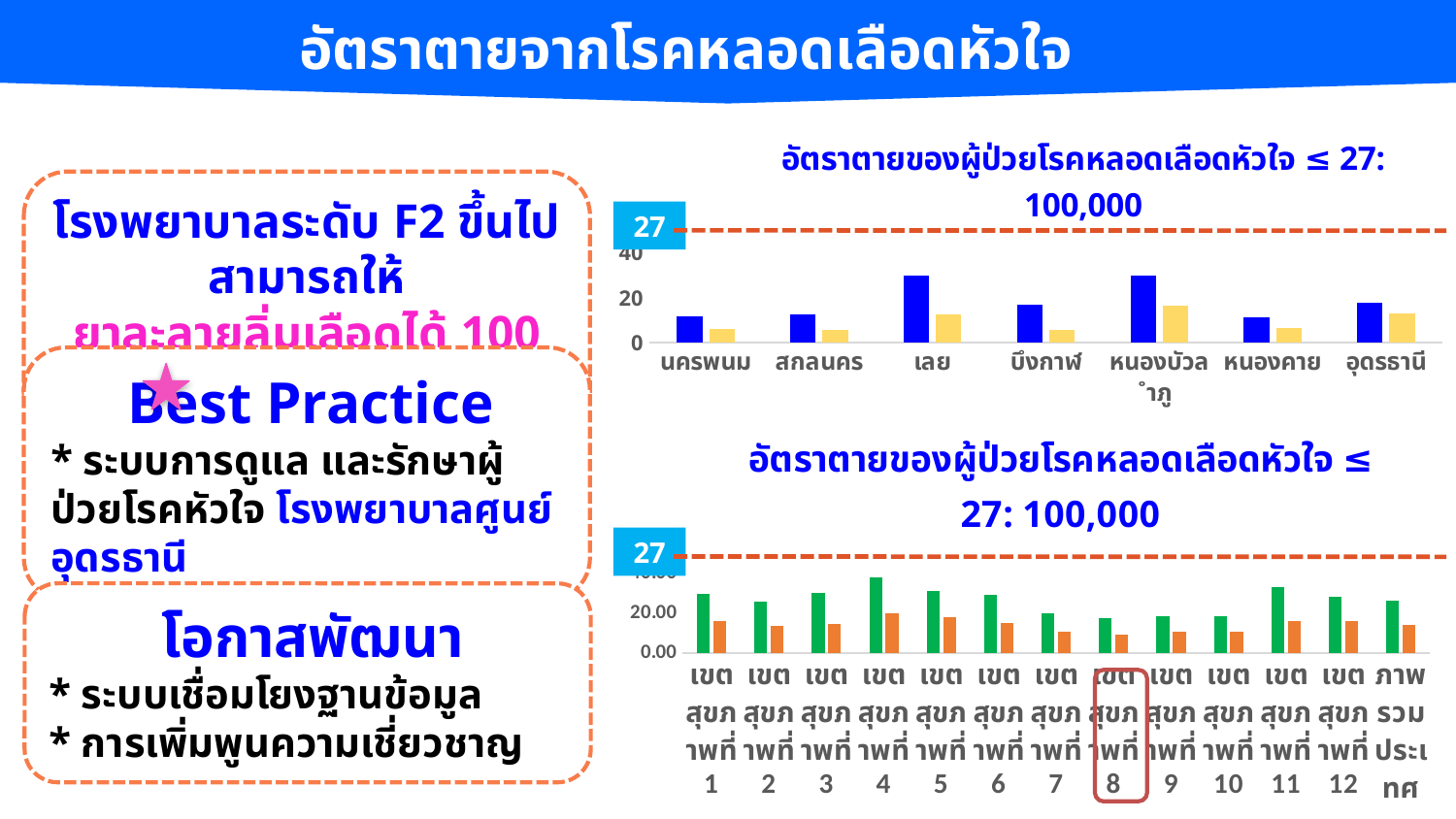
In the bottom chart, is the green bar for เขตสุขภาพที่ 4 greater or less than 20.00? greater In the bottom chart, is the orange bar for เขตสุขภาพที่ 8 greater or less than 20.00? less How many provinces are shown on the x axis of the top chart? 7 What kind of chart is the top chart on the slide (อัตราตายของผู้ป่วยโรคหลอดเลือดหัวใจ ≤ 27: 100,000 by province)? bar chart In the top chart, which has the taller blue bar, เลย or สกลนคร? เลย What kind of chart is the bottom chart on the slide (by เขตสุขภาพ)? bar chart In the top chart, is the blue bar for เลย greater or less than 20? greater How many categories are shown on the x axis of the bottom chart? 13 In the bottom chart, which เขตสุขภาพ has the tallest green bar? เขตสุขภาพที่ 4 What value is marked by the dashed target line on both charts? 27